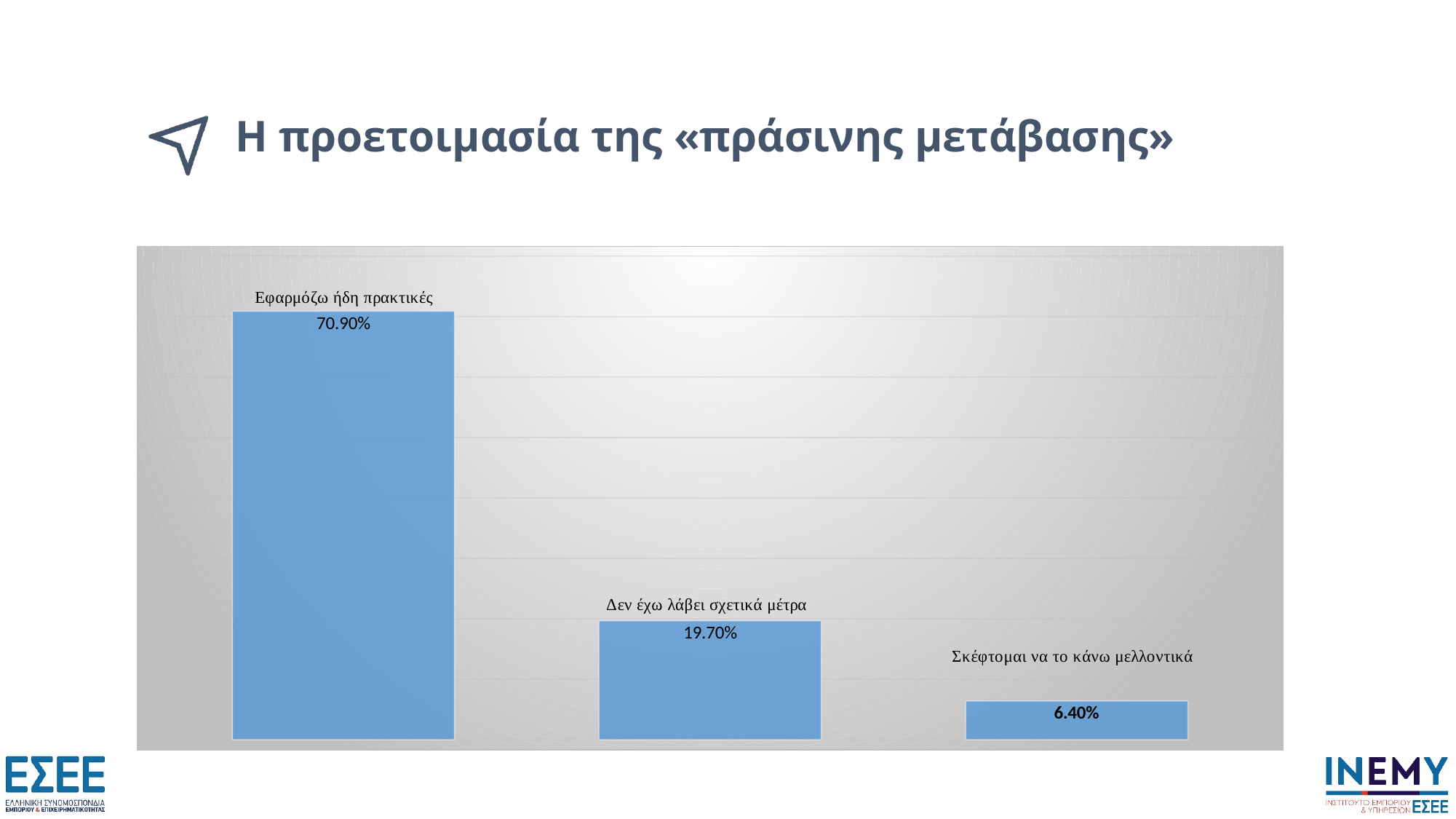
Do the values rise or fall from left to right across the categories? Fall How many categories are shown in the chart? 3 What is the difference between the values for "Δεν έχω λάβει σχετικά μέτρα" and "Σκέφτομαι να το κάνω μελλοντικά"? 13.30% Which is larger: the value for "Δεν έχω λάβει σχετικά μέτρα" or the value for "Σκέφτομαι να το κάνω μελλοντικά"? Δεν έχω λάβει σχετικά μέτρα What is the value for "Εφαρμόζω ήδη πρακτικές"? 70.90% What is the difference between the values for "Εφαρμόζω ήδη πρακτικές" and "Δεν έχω λάβει σχετικά μέτρα"? 51.20% What is the value for "Δεν έχω λάβει σχετικά μέτρα"? 19.70% What kind of chart is shown on the slide? Bar chart Which category has the lowest value? Σκέφτομαι να το κάνω μελλοντικά Which category has the highest value? Εφαρμόζω ήδη πρακτικές What is the title of the slide? Η προετοιμασία της «πράσινης μετάβασης» What is the value for "Σκέφτομαι να το κάνω μελλοντικά"? 6.40%